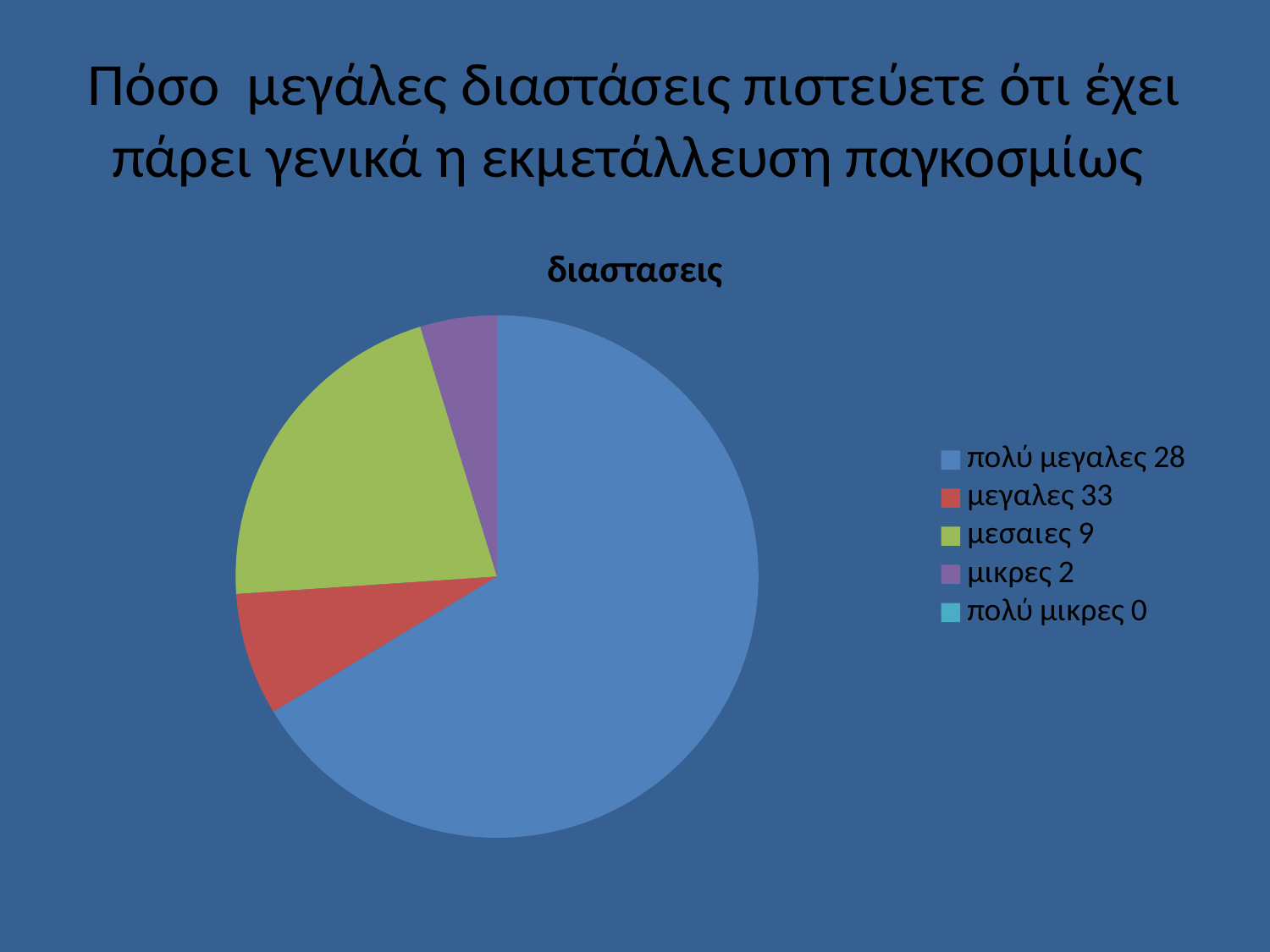
Which category has the smallest visible slice of the pie? μικρες 2 What is the title of the chart? διαστασεις How many entries does the chart's legend list? 5 Which slice is larger, the one for πολύ μεγαλες 28 or the one for μεγαλες 33? πολύ μεγαλες 28 Which category has the largest slice of the pie? πολύ μεγαλες 28 Does the slice for πολύ μεγαλες 28 take up more or less than half of the pie? more Which slice is larger, the one for μεσαιες 9 or the one for μικρες 2? μεσαιες 9 What colour is the slice for μεσαιες 9? green Which slice is larger, the one for μεσαιες 9 or the one for μεγαλες 33? μεσαιες 9 What kind of chart is shown on the slide? pie chart